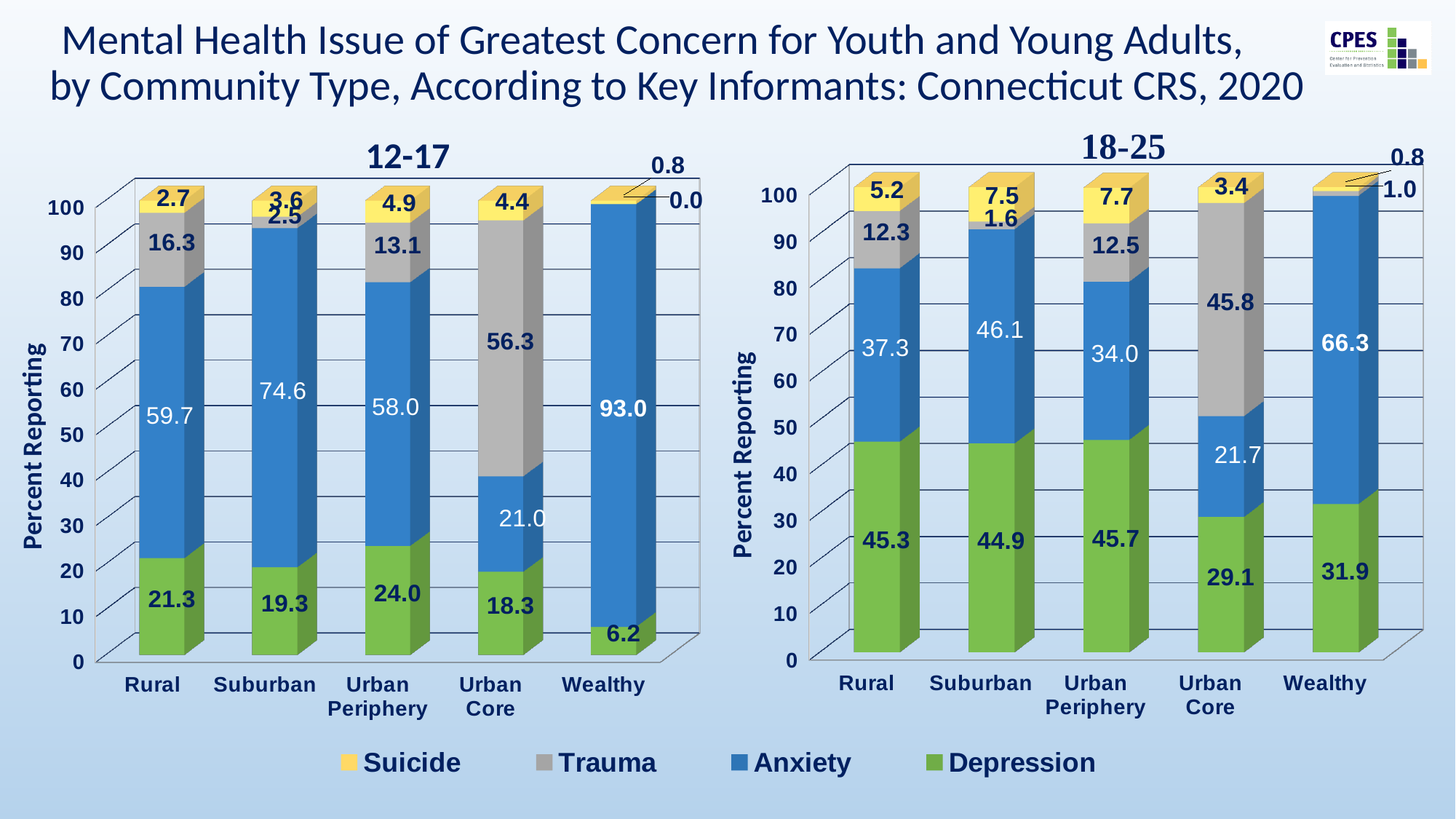
What kind of chart is the 12-17 chart? Stacked bar chart In the 12-17 chart, which community type has the highest Anxiety value? Wealthy In the 18-25 chart, what is the Suicide value for Urban Periphery? 7.7 In the 18-25 chart, which community type has the lowest Depression value? Urban Core In the 18-25 chart, what is the difference between the Anxiety values for Wealthy and Urban Core? 44.6 In the 12-17 chart, which is larger: the Depression value for Urban Periphery or for Suburban? Urban Periphery In the 18-25 chart, what is the Depression value for Rural communities? 45.3 Which series is shown in yellow in the legend? Suicide How many series does the legend list? 4 How many community types are shown on the x axis of the 18-25 chart? 5 In the 12-17 chart, what is the Trauma value for Urban Core? 56.3 In the 12-17 chart, what is the Anxiety value for Wealthy communities? 93.0